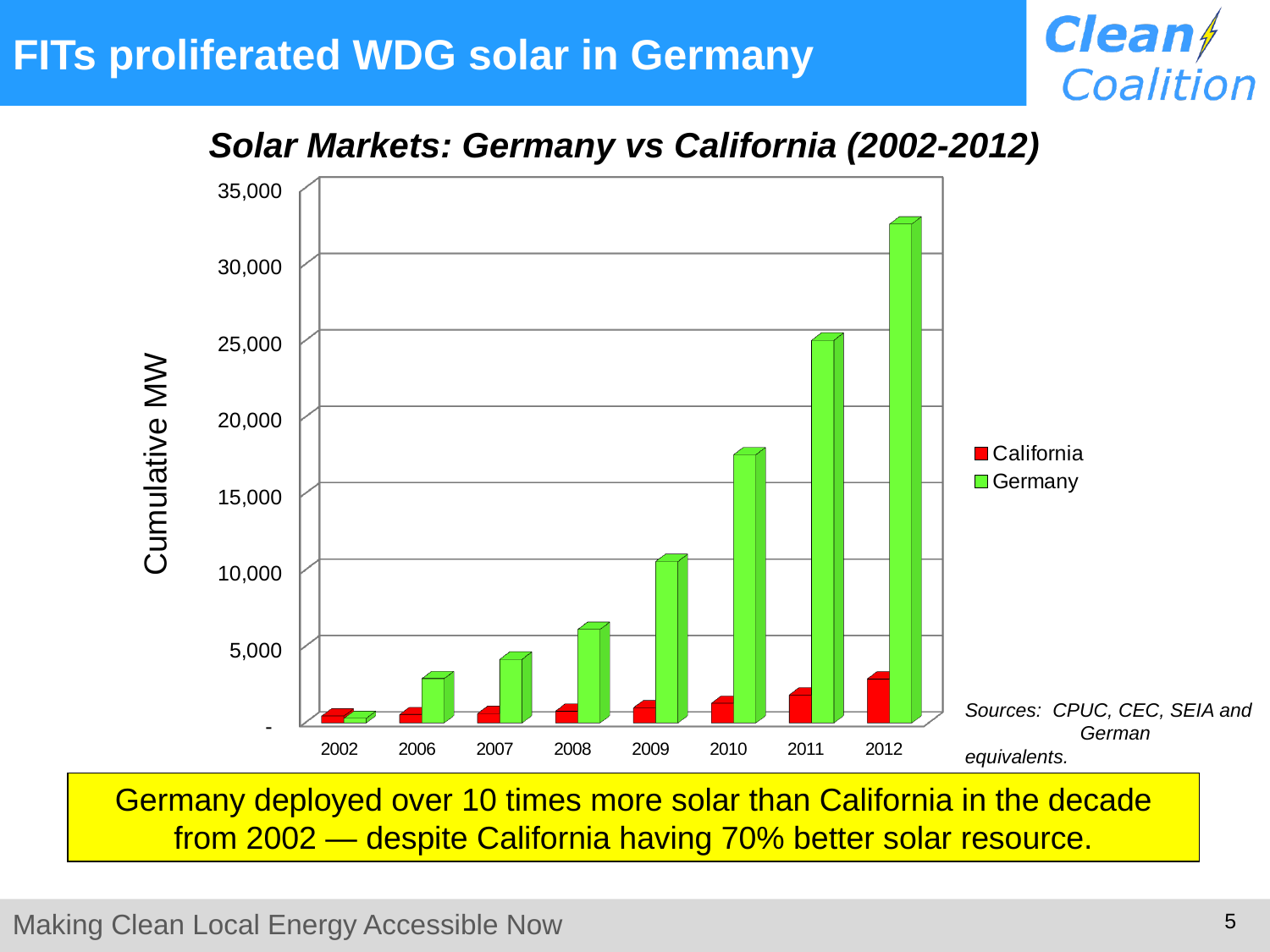
What kind of chart is shown on the slide? bar chart In which year is the Germany bar lowest? 2002 How many series does the chart's legend list? 2 In 2012, which is larger, the Germany bar or the California bar? Germany What is the label on the chart's vertical axis? Cumulative MW How many years are shown on the x axis of the chart? 8 Is the value for California in 2012 greater or less than 5,000? less Is the value for Germany in 2012 greater or less than 30,000? greater Is the value for Germany in 2010 greater or less than 15,000? greater In which year is the Germany bar highest? 2012 Do the Germany values rise or fall from 2002 to 2012? rise